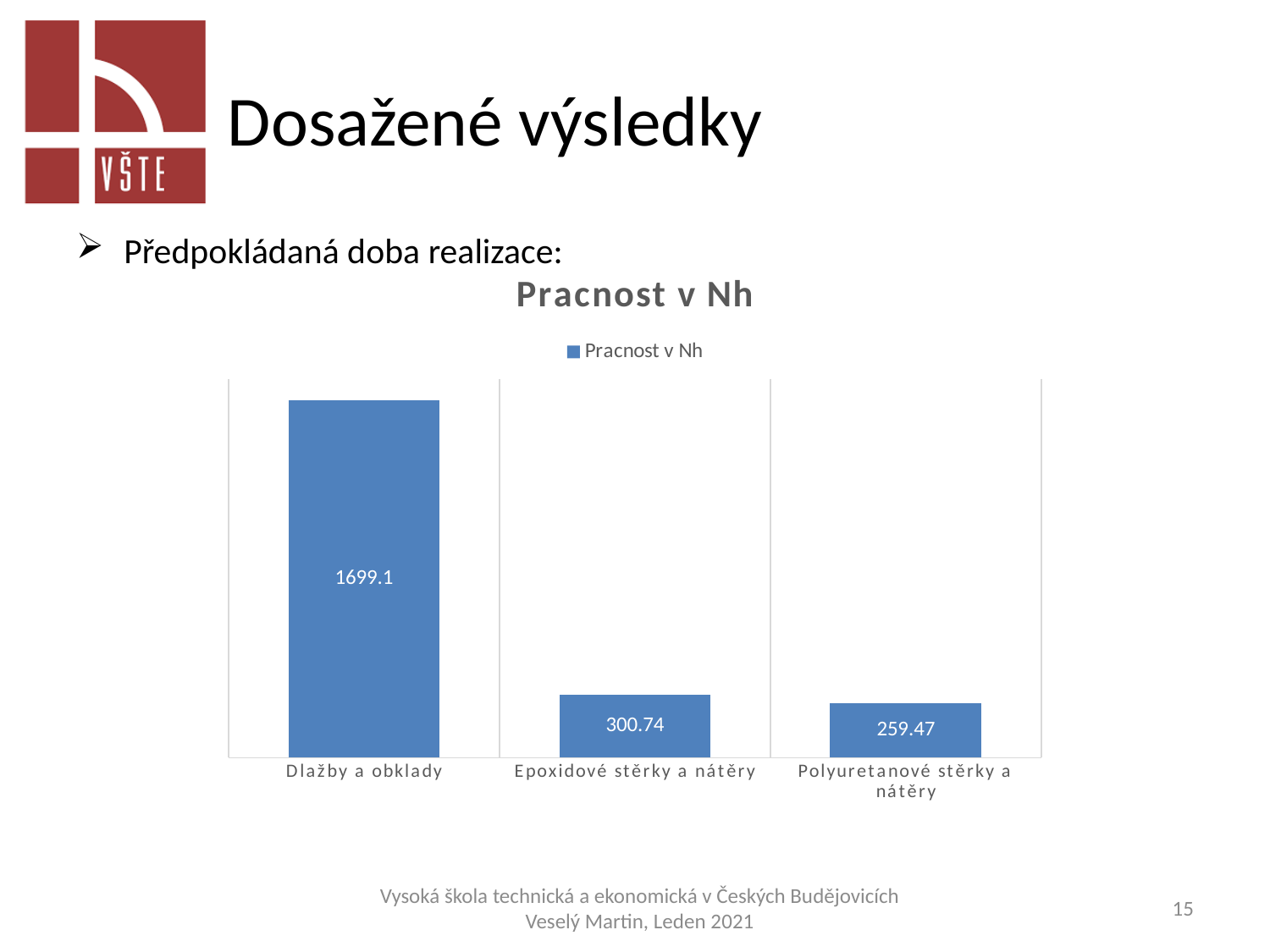
What is the value for Epoxidové stěrky a nátěry? 300.74 What is the value for Polyuretanové stěrky a nátěry? 259.47 How many categories are shown in the chart? 3 What is the difference between the values for Dlažby a obklady and Epoxidové stěrky a nátěry? 1398.36 What kind of chart is shown on the slide? Bar chart Which category has the highest Pracnost v Nh? Dlažby a obklady Which category has the lowest Pracnost v Nh? Polyuretanové stěrky a nátěry What is the difference between the values for Epoxidové stěrky a nátěry and Polyuretanové stěrky a nátěry? 41.27 Which is larger, the value for Epoxidové stěrky a nátěry or for Polyuretanové stěrky a nátěry? Epoxidové stěrky a nátěry How many series does the legend list? 1 What is the value for Dlažby a obklady in the Pracnost v Nh chart? 1699.1 What is the title of the chart? Pracnost v Nh